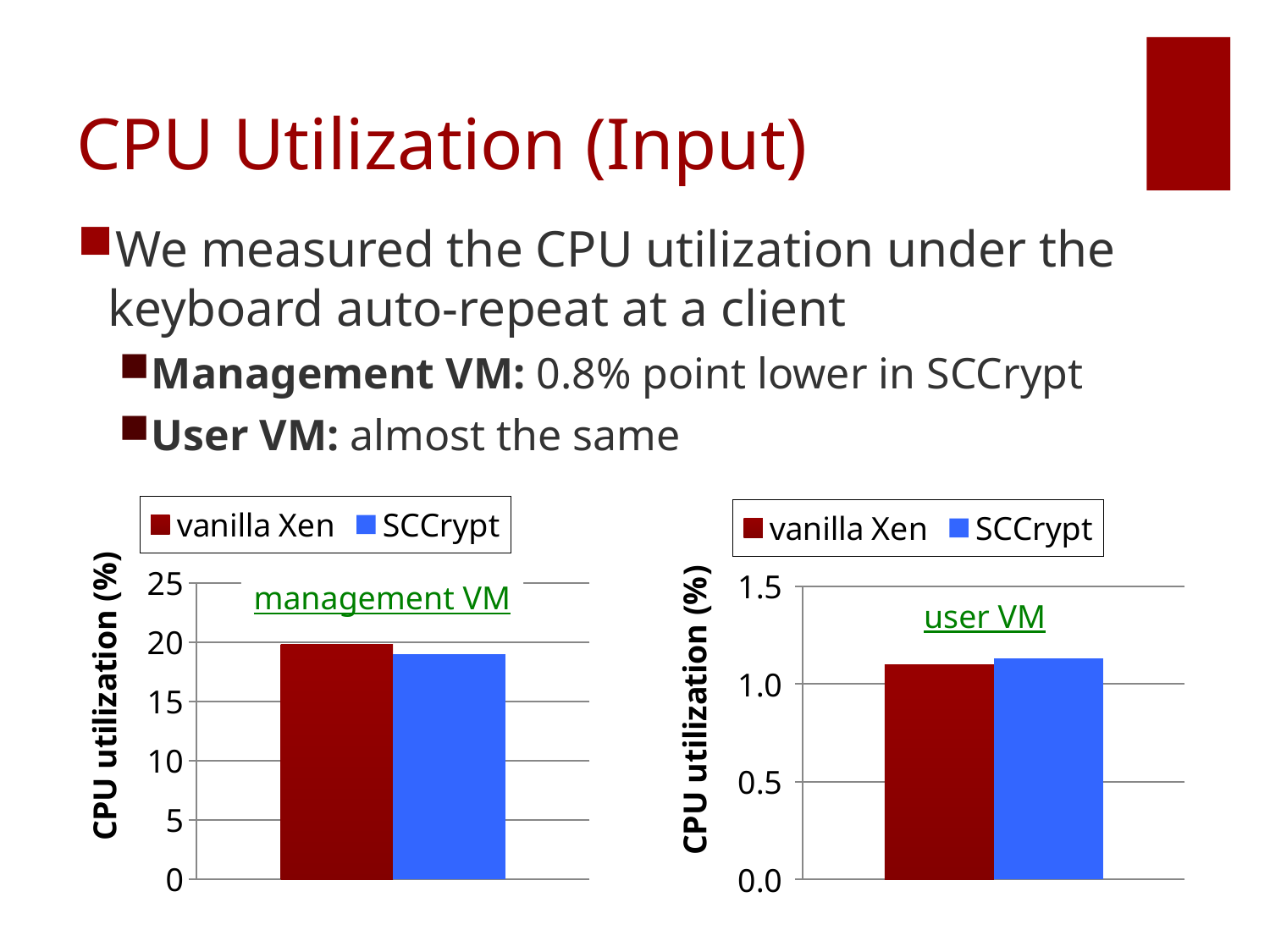
In the management VM chart on the left, is the value for SCCrypt greater or less than 20? less What is the y-axis title of the management VM chart on the left? CPU utilization (%) How many series does the legend of the user VM chart on the right list? 2 How many bars are plotted in the user VM chart on the right? 2 In the management VM chart on the left, is the value for SCCrypt greater or less than 15? greater What are the two legend entries in the management VM chart on the left? vanilla Xen and SCCrypt In the user VM chart on the right, is the value for vanilla Xen greater or less than 1.0? greater What kind of chart is the management VM chart on the left? bar chart In the management VM chart on the left, which series has the taller bar, vanilla Xen or SCCrypt? vanilla Xen